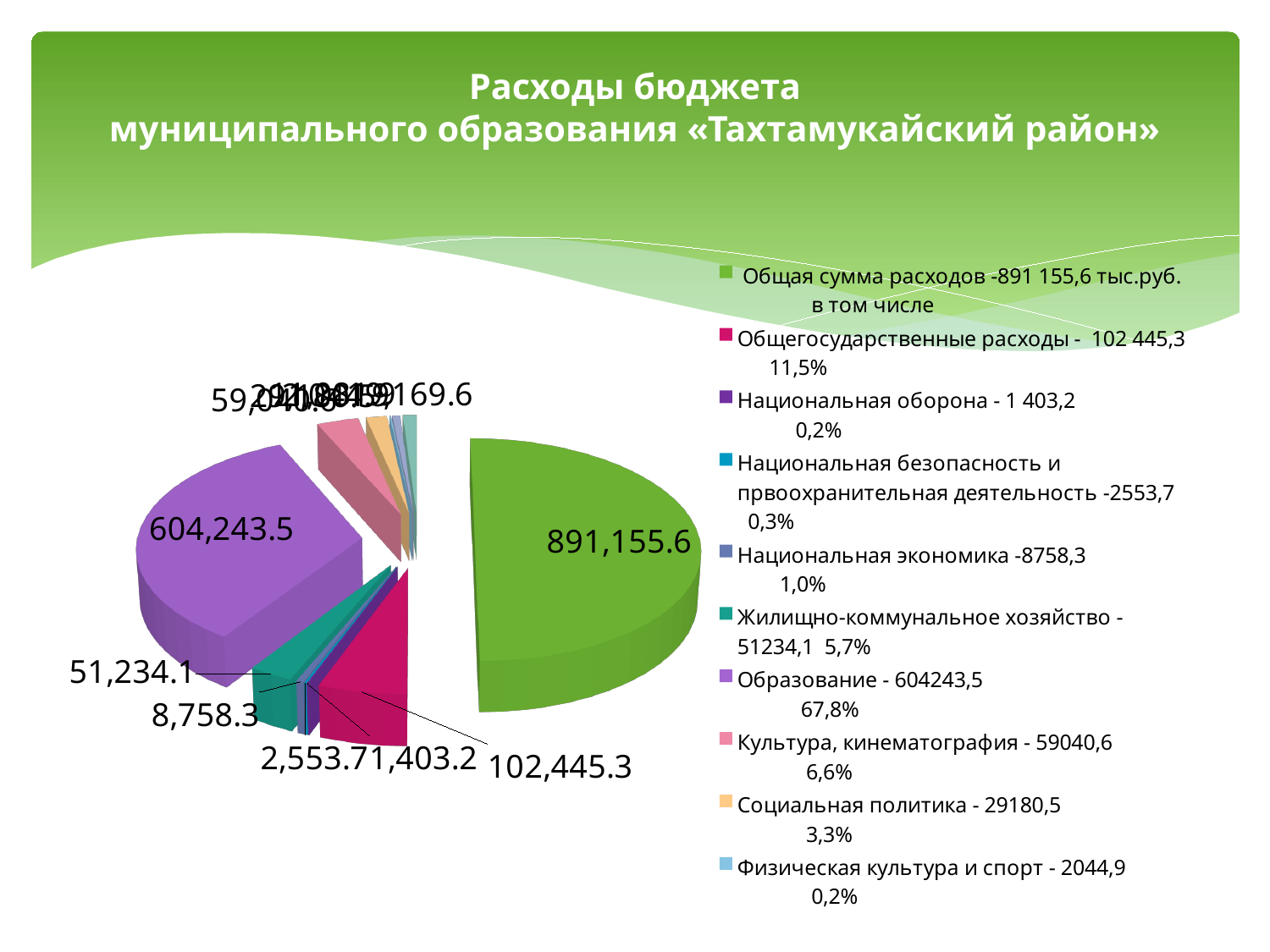
What is the value shown for Общегосударственные расходы on the pie chart? 102,445.3 Which is larger on the pie chart: Образование or Общегосударственные расходы? Образование According to the legend, what share of expenses does Образование account for? 67,8% What is the value shown for Жилищно-коммунальное хозяйство on the pie chart? 51,234.1 What is the value shown for Национальная экономика on the pie chart? 8,758.3 What is the difference between the values for Жилищно-коммунальное хозяйство and Национальная экономика? 42,475.8 What type of chart is shown on the slide? pie chart How many entries does the legend of the pie chart list? 10 What is the value shown for Национальная оборона on the pie chart? 1,403.2 What is the difference between the values for Образование and Общегосударственные расходы? 501,798.2 Which slice of the pie chart has the largest value? Общая сумма расходов (891,155.6) What is the value shown for Образование on the pie chart? 604,243.5